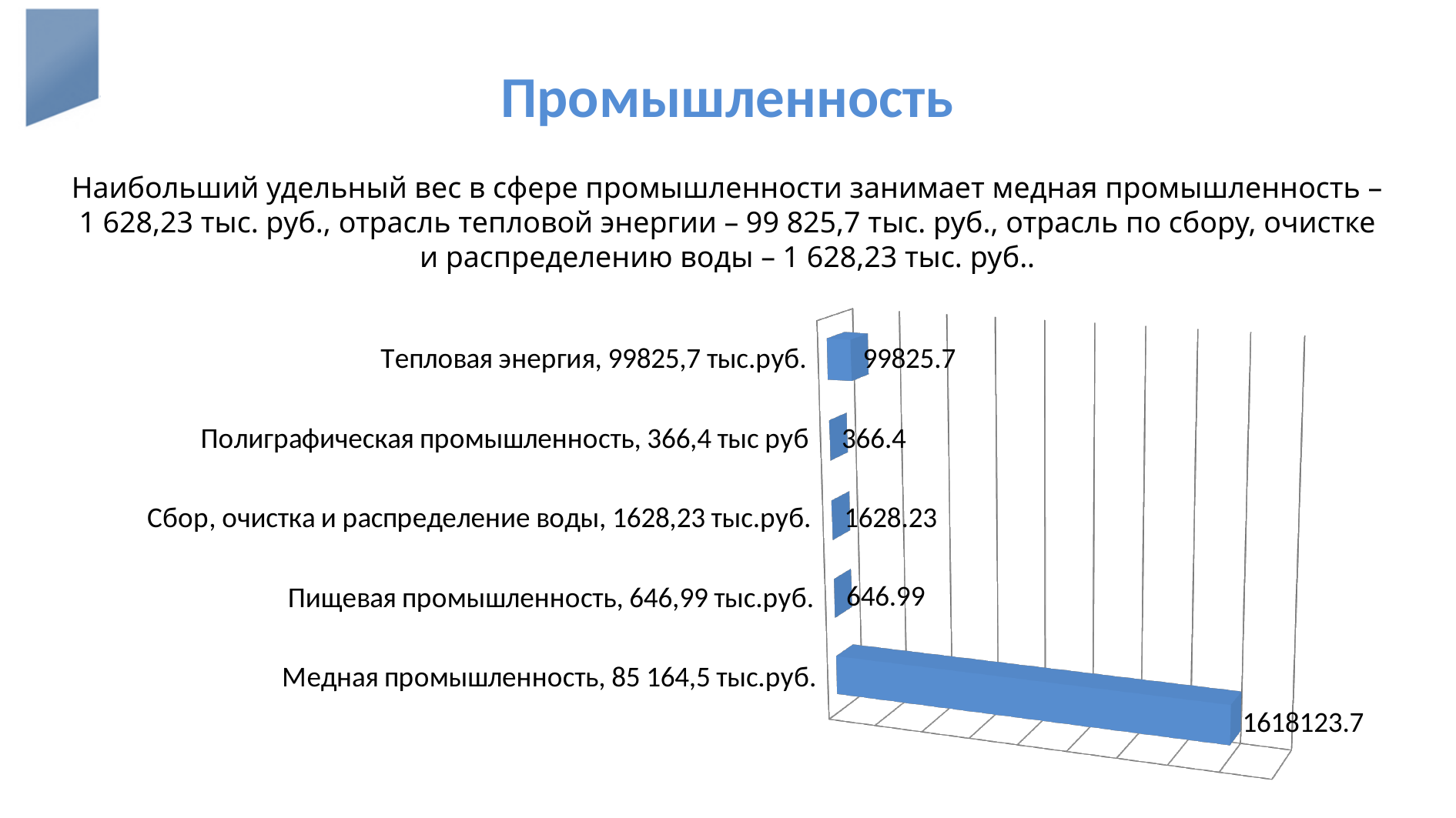
What is the data label value for Пищевая промышленность? 646.99 Which category has the highest value in the chart? Медная промышленность What kind of chart is shown on the slide? Bar chart What is the difference between the data label values for Тепловая энергия and Полиграфическая промышленность? 99459.3 How many categories are shown in the chart? 5 What is the data label value for Полиграфическая промышленность? 366.4 Which category has the lowest value in the chart? Полиграфическая промышленность Which is larger: the value for Пищевая промышленность or the value for Сбор, очистка и распределение воды? Сбор, очистка и распределение воды What is the difference between the data label values for Сбор, очистка и распределение воды and Пищевая промышленность? 981.24 What is the data label value for Сбор, очистка и распределение воды? 1628.23 What is the data label value for Тепловая энергия? 99825.7 What is the data label value for Медная промышленность? 1618123.7